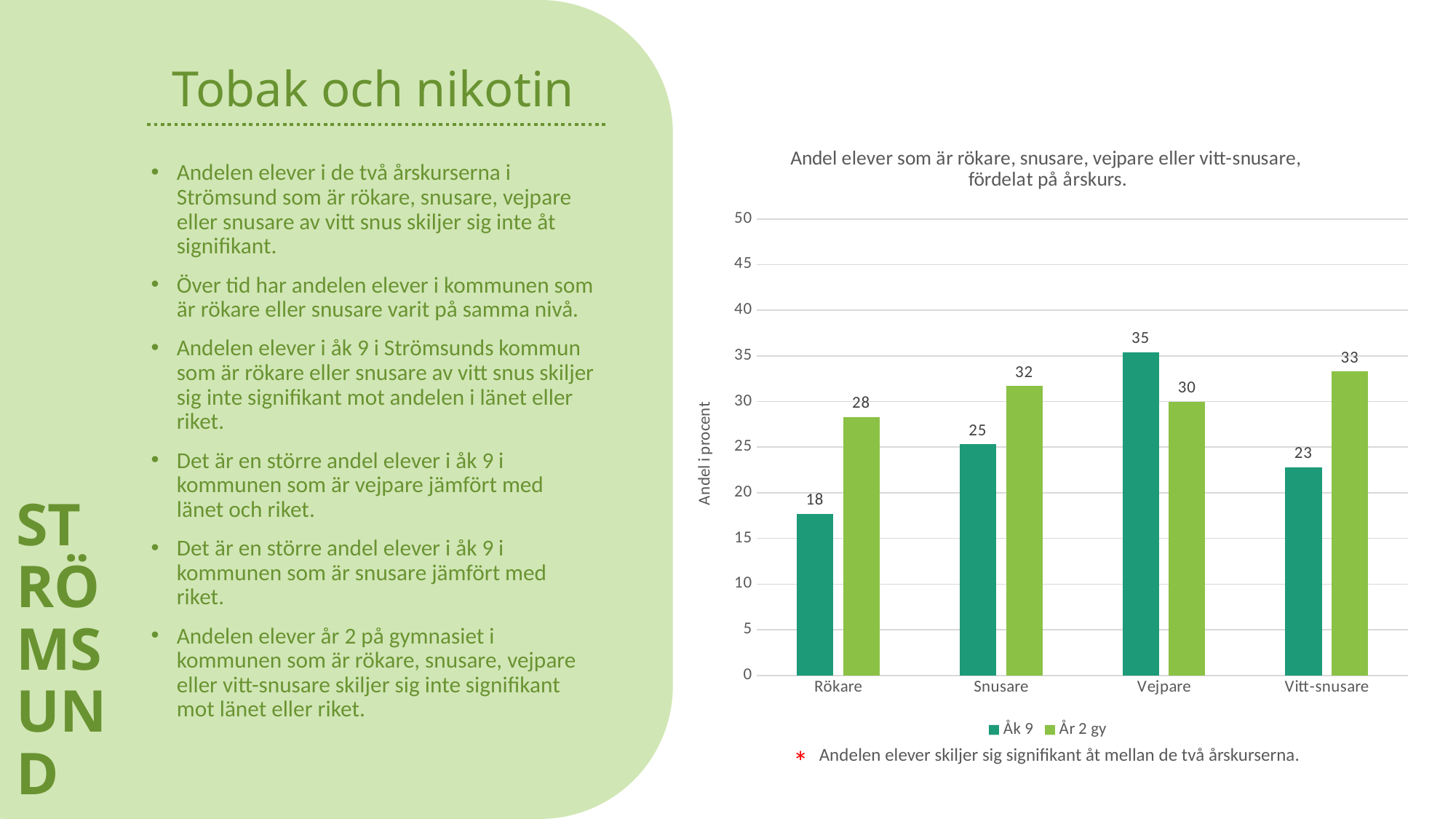
What is the value for År 2 gy in the Snusare category? 32 What is the value for Åk 9 in the Vejpare category? 35 Which is larger in the Vejpare category, Åk 9 or År 2 gy? Åk 9 What is the label of the y axis? Andel i procent How many categories are shown on the x axis? 4 Which category has the lowest value for År 2 gy? Rökare What is the difference between the År 2 gy and Åk 9 values in the Rökare category? 10 What kind of chart is shown on the slide? Bar chart How many series does the legend list? 2 Which category has the highest value for Åk 9? Vejpare What is the value for Åk 9 in the Rökare category? 18 What is the value for År 2 gy in the Vitt-snusare category? 33